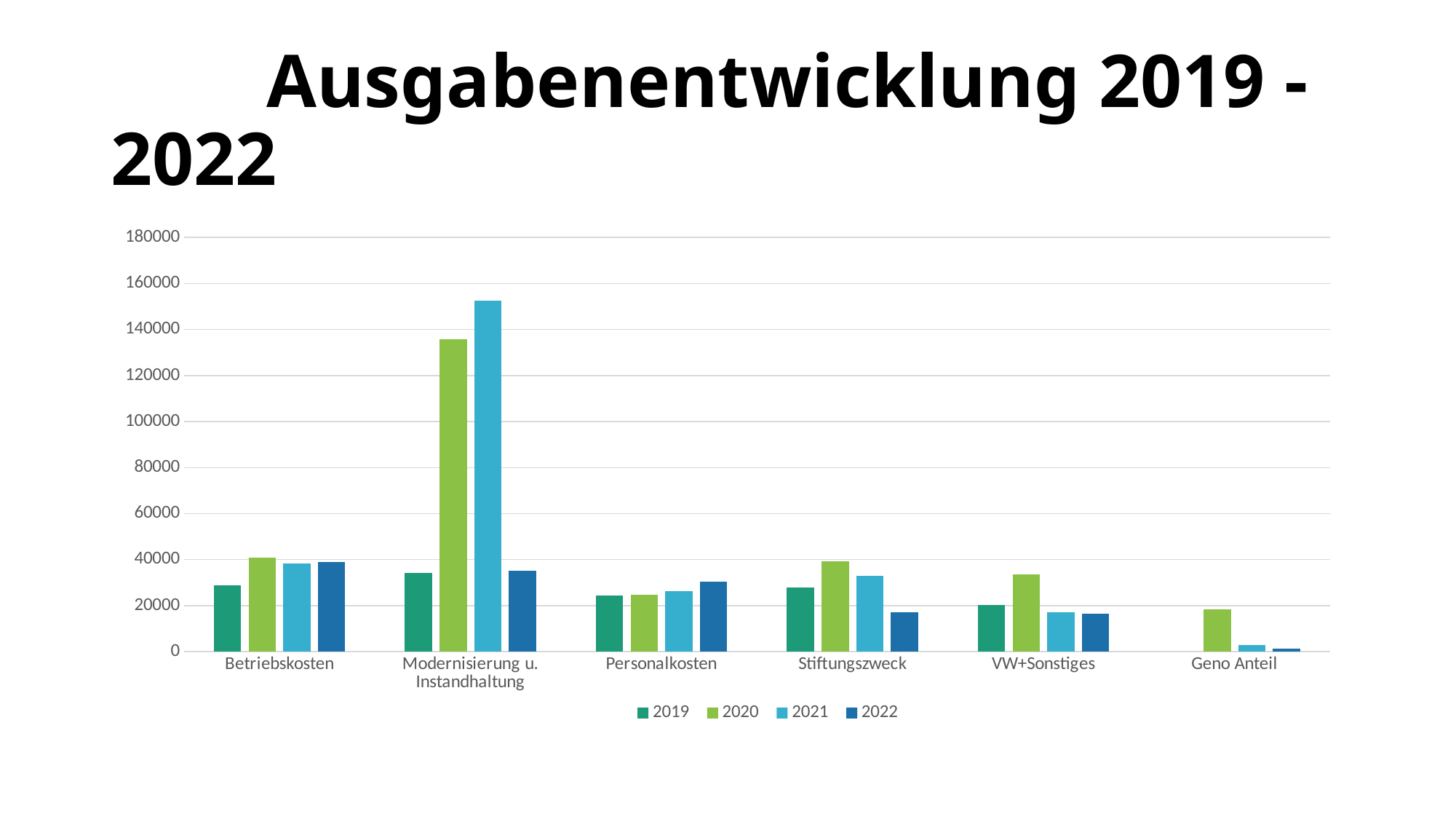
For VW+Sonstiges, which year has the larger value, 2019 or 2020? 2020 How many series does the legend list? 4 For Stiftungszweck, which year has the larger value, 2020 or 2022? 2020 Is the 2020 value for Modernisierung u. Instandhaltung greater or less than 120000? greater What kind of chart is shown on the slide? bar chart Is the 2019 value for Betriebskosten greater or less than 40000? less How many categories are shown on the x axis? 6 Which category has the lowest bar for 2022? Geno Anteil Which category has the highest bar for 2021? Modernisierung u. Instandhaltung What is the title of the chart on the slide? Ausgabenentwicklung 2019 - 2022 Is the 2021 value for Modernisierung u. Instandhaltung greater or less than 140000? greater